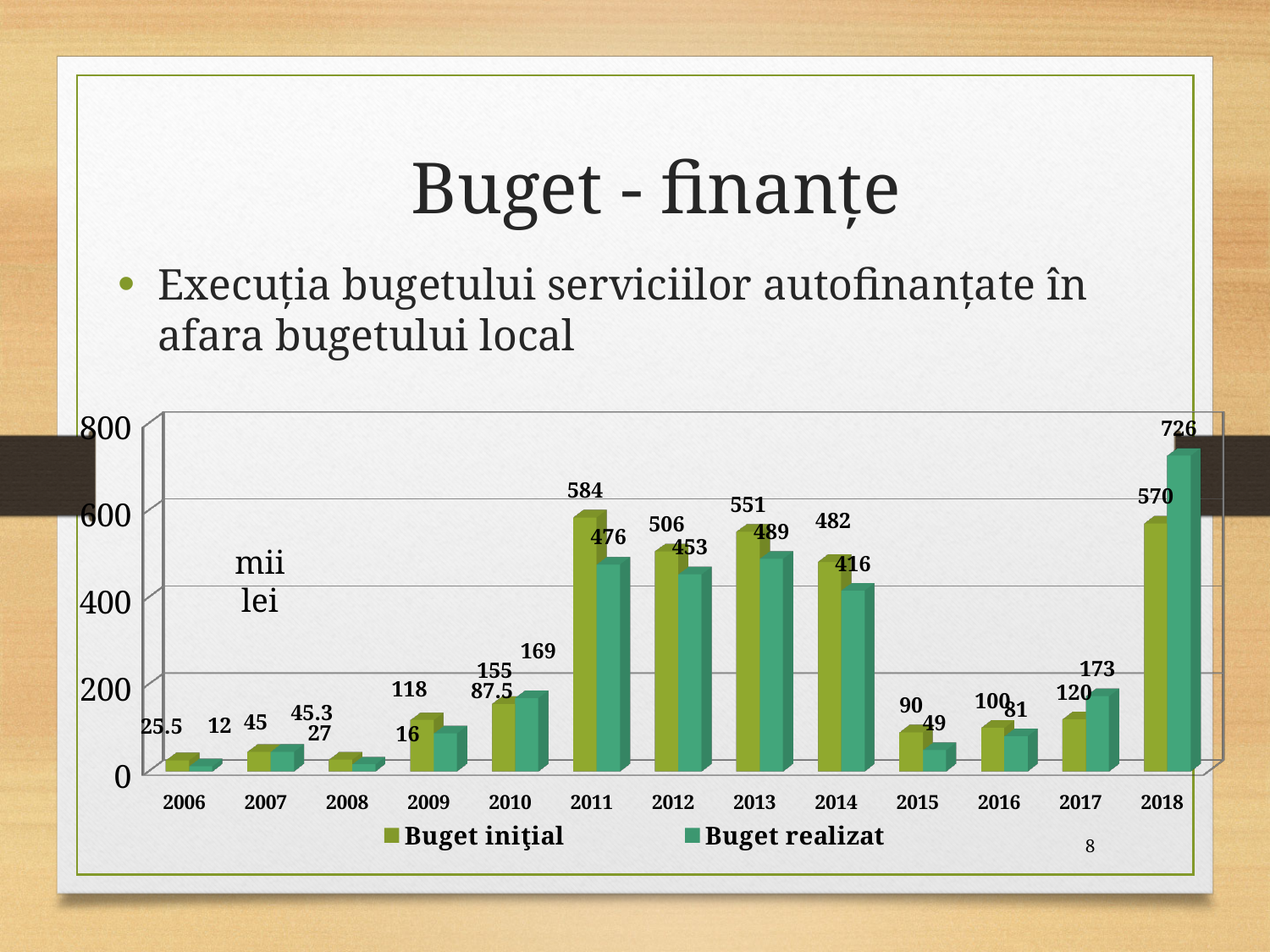
Which is larger in 2017, Buget iniţial or Buget realizat? Buget realizat Is the value of Buget iniţial for 2014 greater or less than 400? greater Which year has the highest Buget realizat value? 2018 What unit is indicated on the chart? mii lei How many series does the legend list? 2 What is the value of Buget iniţial for 2011? 584 How many years are shown on the x axis? 13 What kind of chart is shown on the slide? bar chart What is the difference between Buget iniţial and Buget realizat in 2011? 108 What is the value of Buget realizat for 2018? 726 What is the value of Buget realizat for 2009? 87.5 Which year has the lowest Buget realizat value? 2006